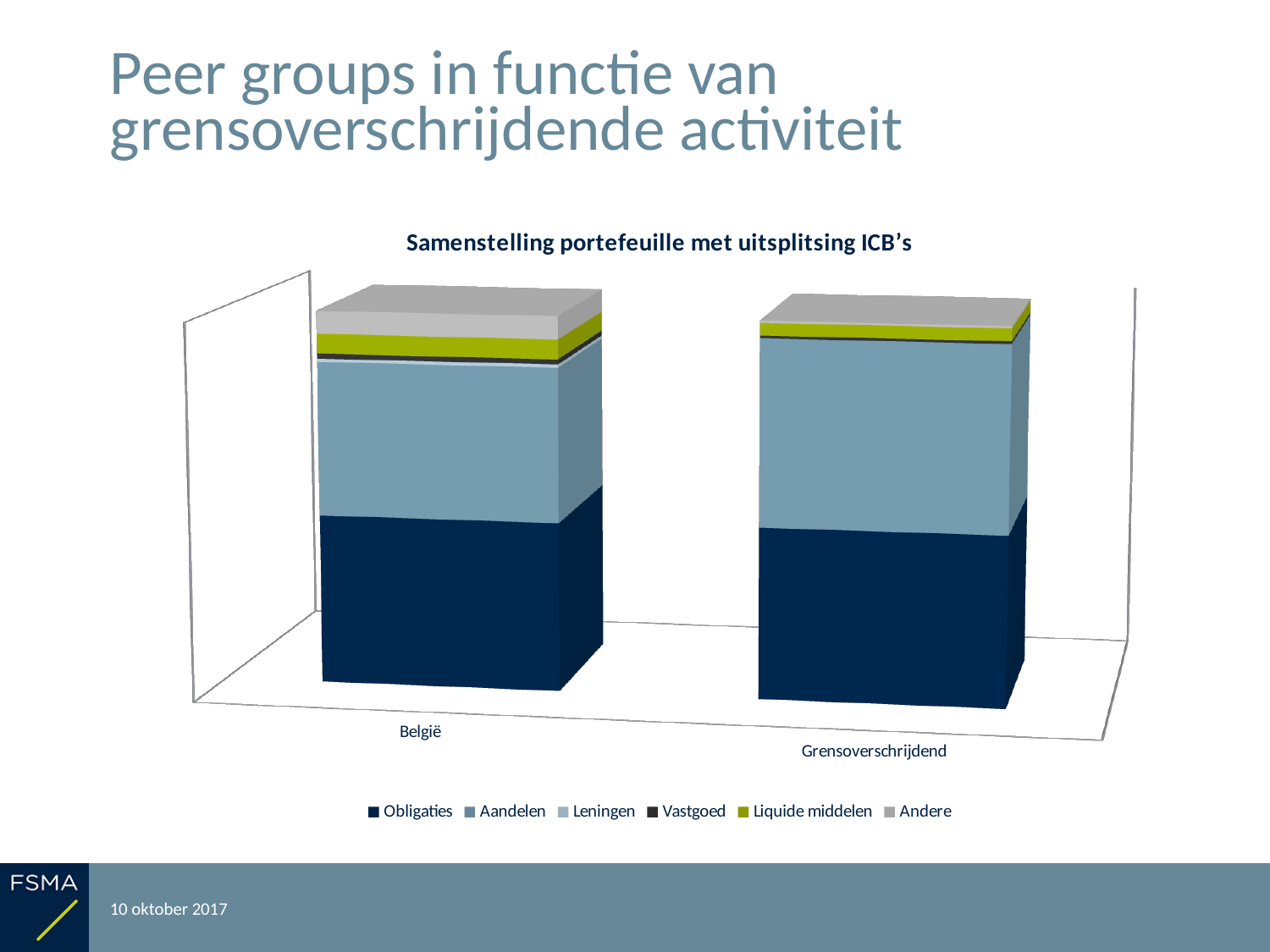
What is the title of the chart? Samenstelling portefeuille met uitsplitsing ICB’s What kind of chart is shown on the slide? Stacked bar chart Which series forms the bottom segment of each stacked bar? Obligaties Which category has the larger Liquide middelen segment: België or Grensoverschrijdend? België In the Grensoverschrijdend bar, which segment is larger: Obligaties or Aandelen? Aandelen How many series does the chart's legend list? 6 How many categories are shown on the x axis of the chart? 2 Which category has the larger Andere segment: België or Grensoverschrijdend? België Which series is listed first in the chart's legend? Obligaties Which two categories are shown on the x axis? België and Grensoverschrijdend